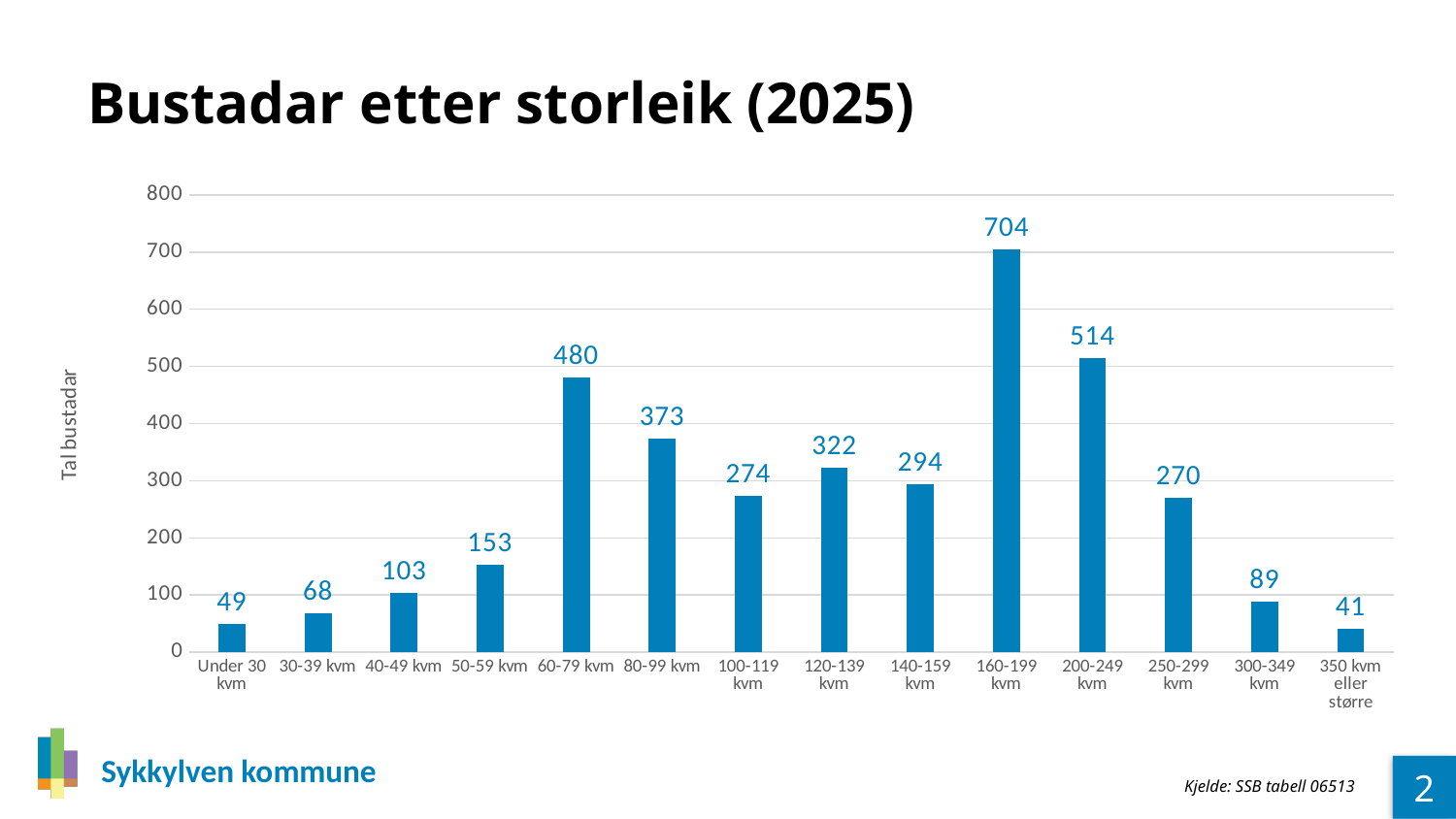
Which category has the lowest value? 350 kvm eller større What is the value for 160-199 kvm? 704 What is the value for 100-119 kvm? 274 What kind of chart is shown on the slide? bar chart What is the label of the vertical axis? Tal bustadar Is the value for 120-139 kvm greater or less than 300? greater Which is larger, the value for 60-79 kvm or the value for 80-99 kvm? 60-79 kvm How many categories are shown on the x axis? 14 What is the value for Under 30 kvm? 49 What is the title of the chart? Bustadar etter storleik (2025) Which category has the highest value? 160-199 kvm What is the difference between the values for 160-199 kvm and 200-249 kvm? 190